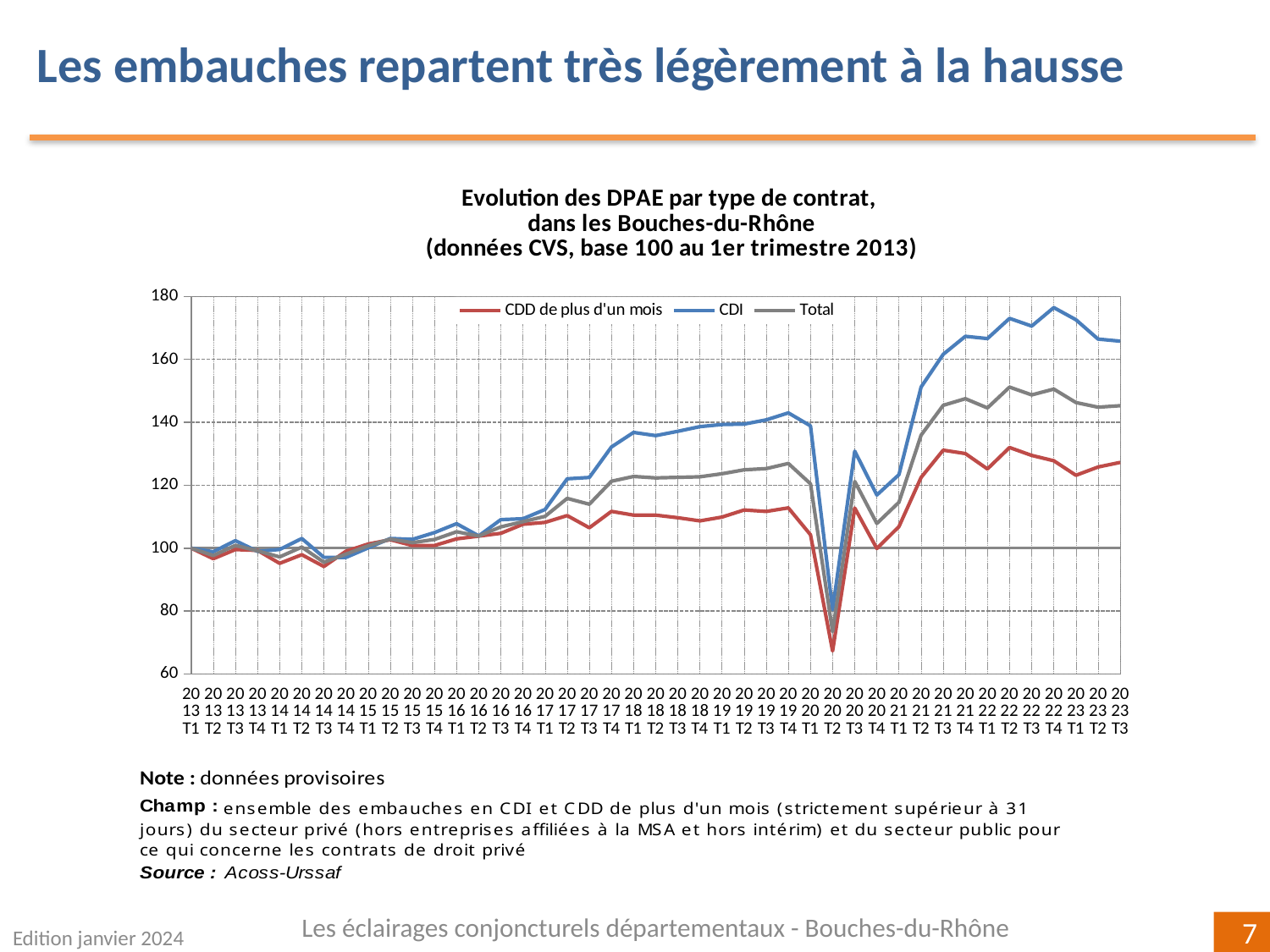
How many series does the legend list? 3 Which series has the highest value at 2023 T3? CDI What kind of chart is shown on the slide? line chart Does the CDI series rise or fall between 2021 T1 and 2021 T3? rise In which quarter does the CDD de plus d'un mois series reach its lowest value? 2020 T2 Which series has the lowest value at 2020 T2? CDD de plus d'un mois Which series is plotted in blue? CDI How many quarters are plotted on the x axis? 43 Is the value for Total at 2023 T3 greater or less than 140? greater Is the value for CDD de plus d'un mois at 2020 T2 greater or less than 80? less Is the value for CDI at 2023 T3 greater or less than 160? greater What is the base value of the index at the first quarter of 2013, according to the chart title? 100